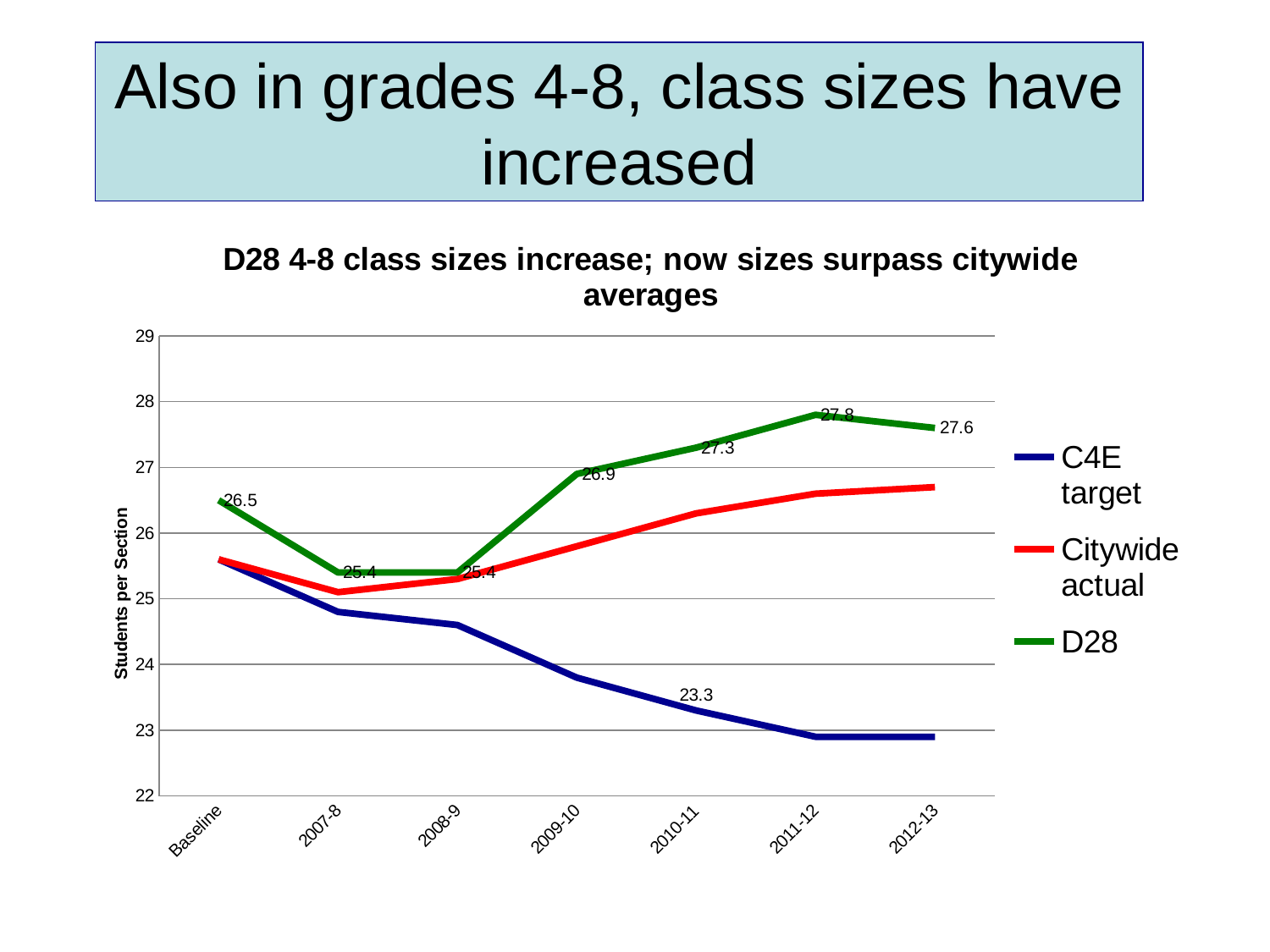
In which year does the D28 series reach its highest value? 2011-12 What is the D28 value at Baseline? 26.5 What is the lowest value shown for the D28 series? 25.4 How many time periods are shown on the x axis? 7 Is the Citywide actual value for 2012-13 greater or less than 27? less By how much does the D28 value fall from 2011-12 to 2012-13? 0.2 Which series has the larger value in 2010-11, D28 or C4E target? D28 What is the C4E target value labelled for 2010-11? 23.3 What is the D28 value for 2011-12? 27.8 Does the C4E target series rise or fall from Baseline to 2012-13? fall How many series does the legend list? 3 What kind of chart is shown on the slide? line chart